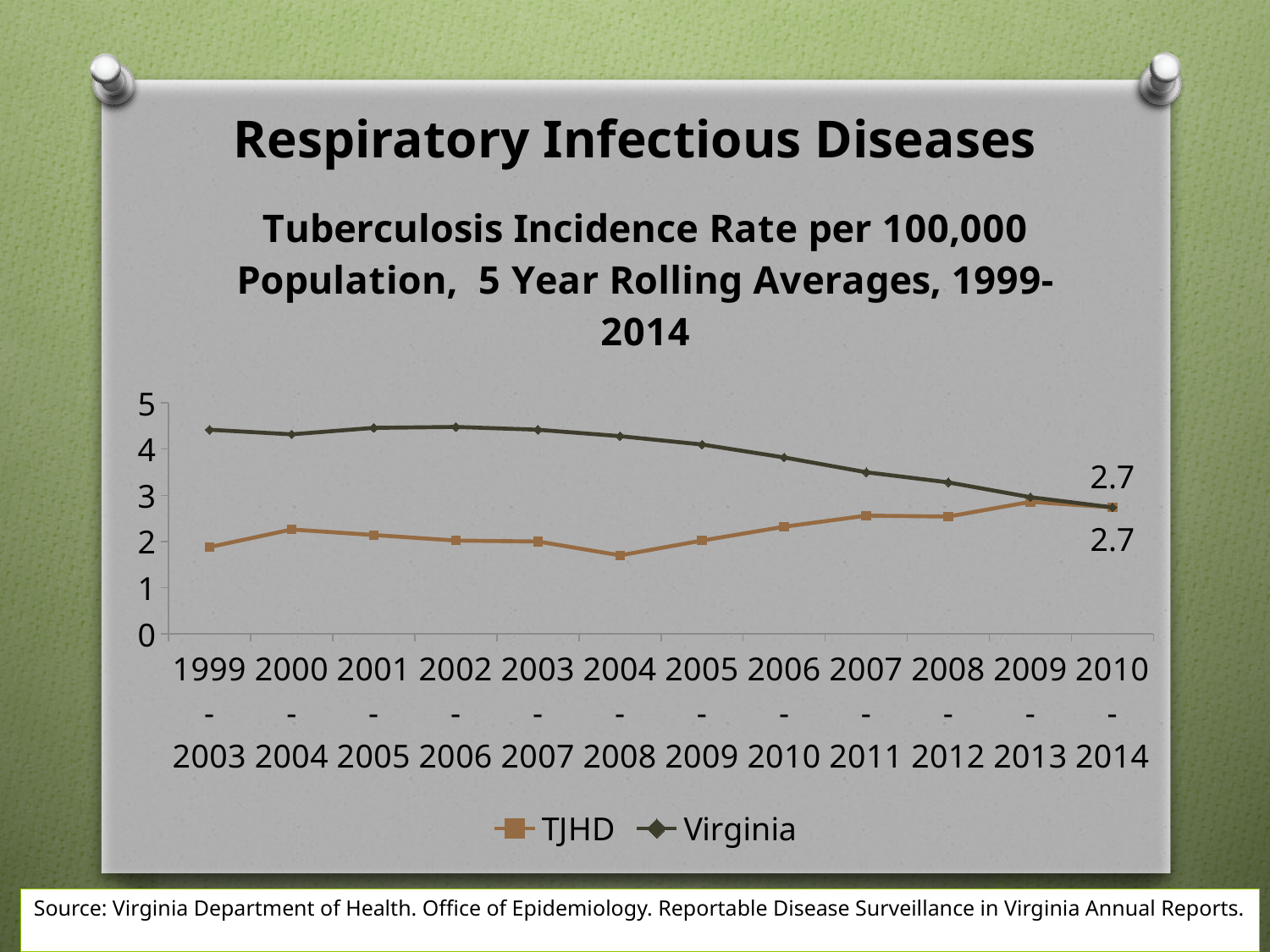
In which period is the TJHD value lowest? 2004-2008 Is the TJHD value for 2004-2008 greater or less than 2? less What is the difference between the Virginia and TJHD values for 2010-2014? 0 Which series has the larger value for the 1999-2003 period, TJHD or Virginia? Virginia What is the TJHD value for the 2010-2014 period? 2.7 Does the Virginia series generally rise or fall across the periods from 1999-2003 to 2010-2014? fall Is the Virginia value for 2008-2012 greater or less than 3? greater What kind of chart is shown on the slide? line chart How many rolling-average periods are plotted along the x axis? 12 What is the Virginia value for the 2010-2014 period? 2.7 Is the Virginia value for 1999-2003 greater or less than 4? greater How many series does the legend list? 2